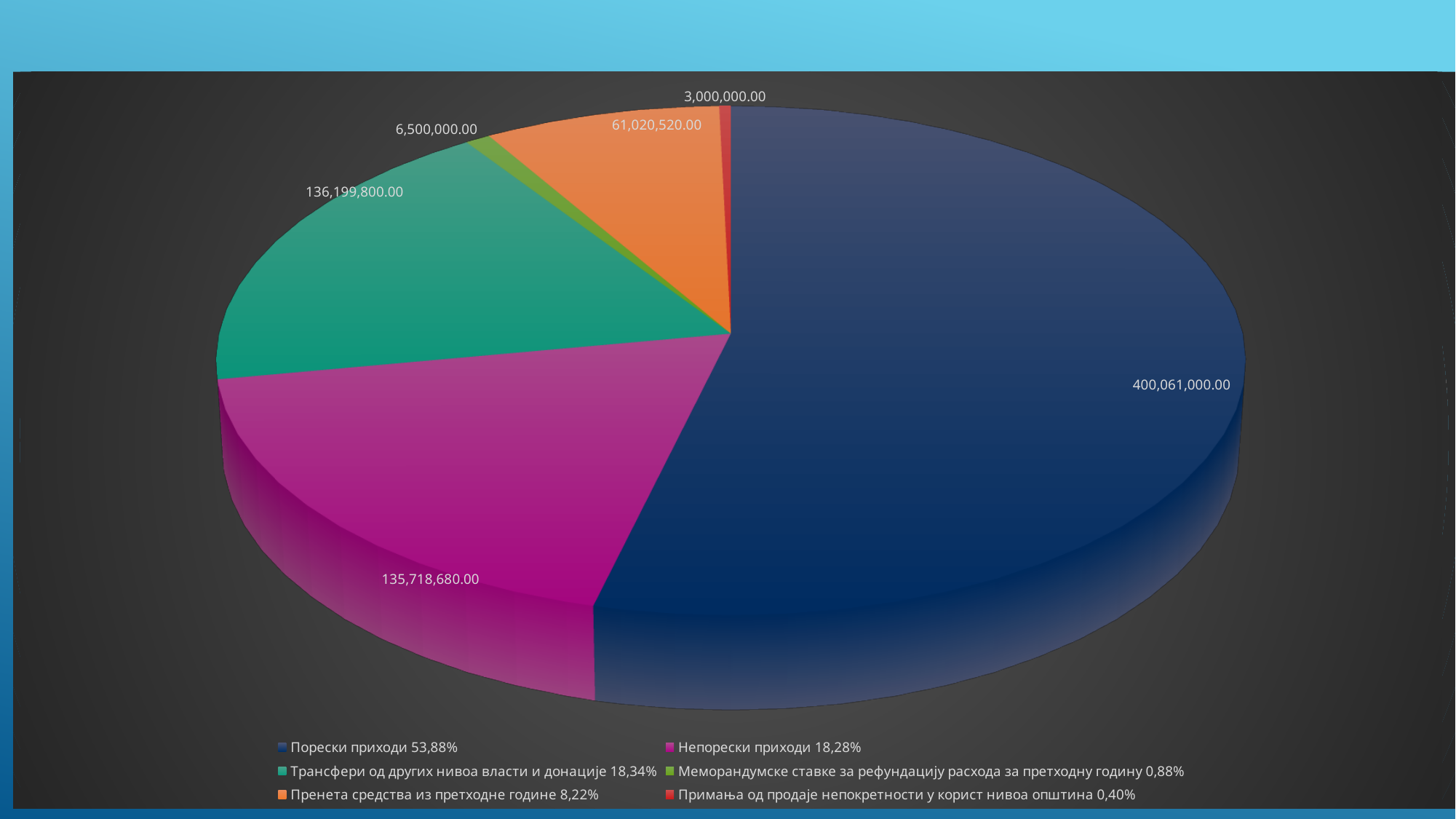
What is the difference between the Трансфери од других нивоа власти и донације value and the Непорески приходи value? 481,120.00 How many slices does the pie chart have? 6 What is the value of the Непорески приходи slice? 135,718,680.00 What is the value of the Меморандумске ставке за рефундацију расхода за претходну годину slice? 6,500,000.00 What share of the pie does Трансфери од других нивоа власти и донације represent, according to the legend? 18,34% Which is larger: the Пренета средства из претходне године slice or the Меморандумске ставке slice? Пренета средства из претходне године Which category has the smallest slice of the pie? Примања од продаје непокретности у корист нивоа општина Which category has the largest slice of the pie? Порески приходи What is the value of the Порески приходи slice? 400,061,000.00 What is the value of the Пренета средства из претходне године slice? 61,020,520.00 What colour is the Порески приходи slice? Dark blue What kind of chart is shown on the slide? Pie chart